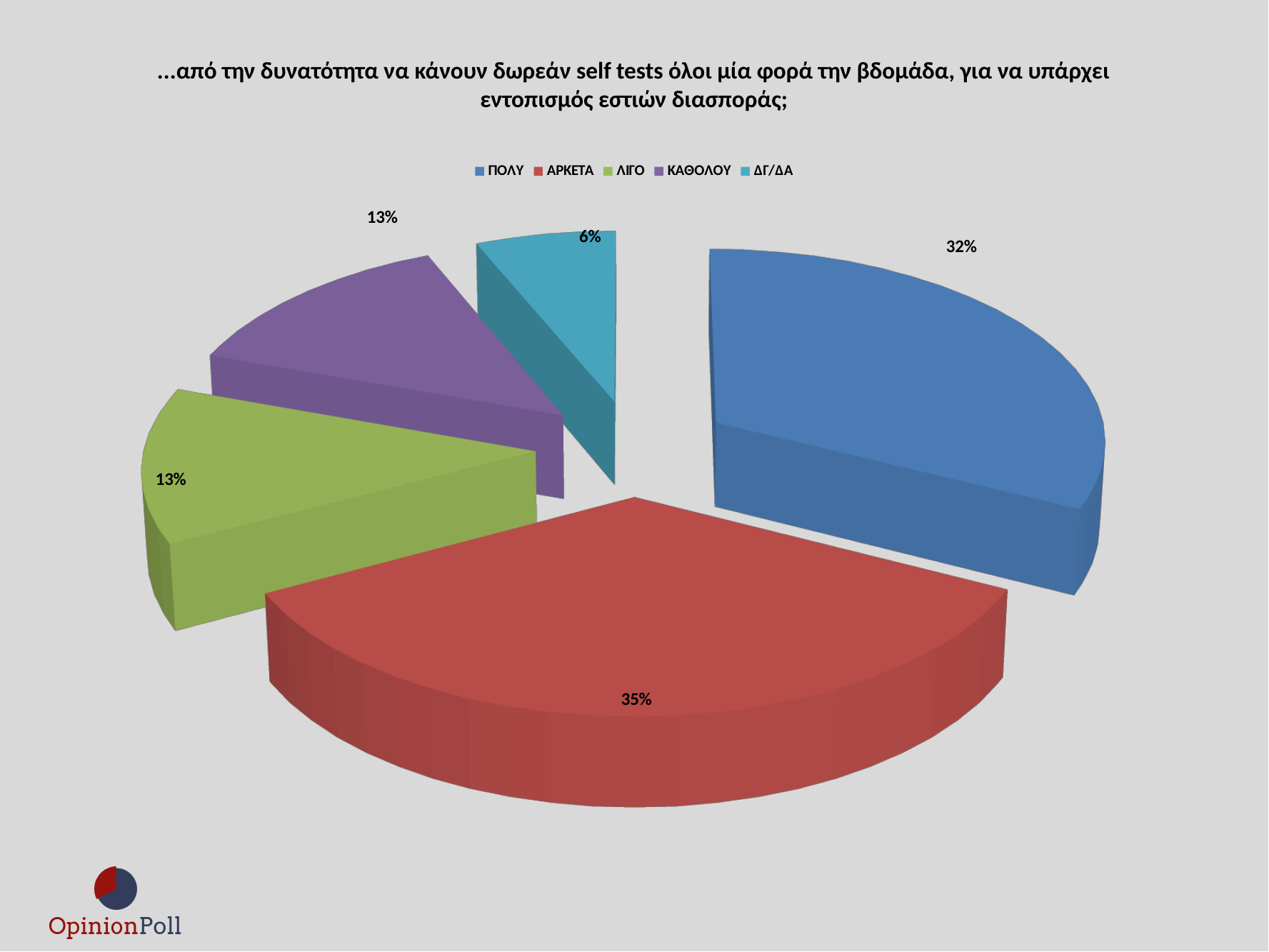
Which category has the smallest share of the pie? ΔΓ/ΔΑ What percentage is shown for ΑΡΚΕΤΑ? 35% What percentage is shown for ΚΑΘΟΛΟΥ? 13% What percentage is shown for ΔΓ/ΔΑ? 6% Which is larger, the share for ΠΟΛΥ or the share for ΛΙΓΟ? ΠΟΛΥ What is the difference in percentage points between ΑΡΚΕΤΑ and ΠΟΛΥ? 3 What percentage is shown for ΠΟΛΥ? 32% What colour is the slice for ΑΡΚΕΤΑ? red What percentage is shown for ΛΙΓΟ? 13% How many categories does the legend list? 5 What kind of chart is shown on the slide? pie chart Which category has the largest share of the pie? ΑΡΚΕΤΑ